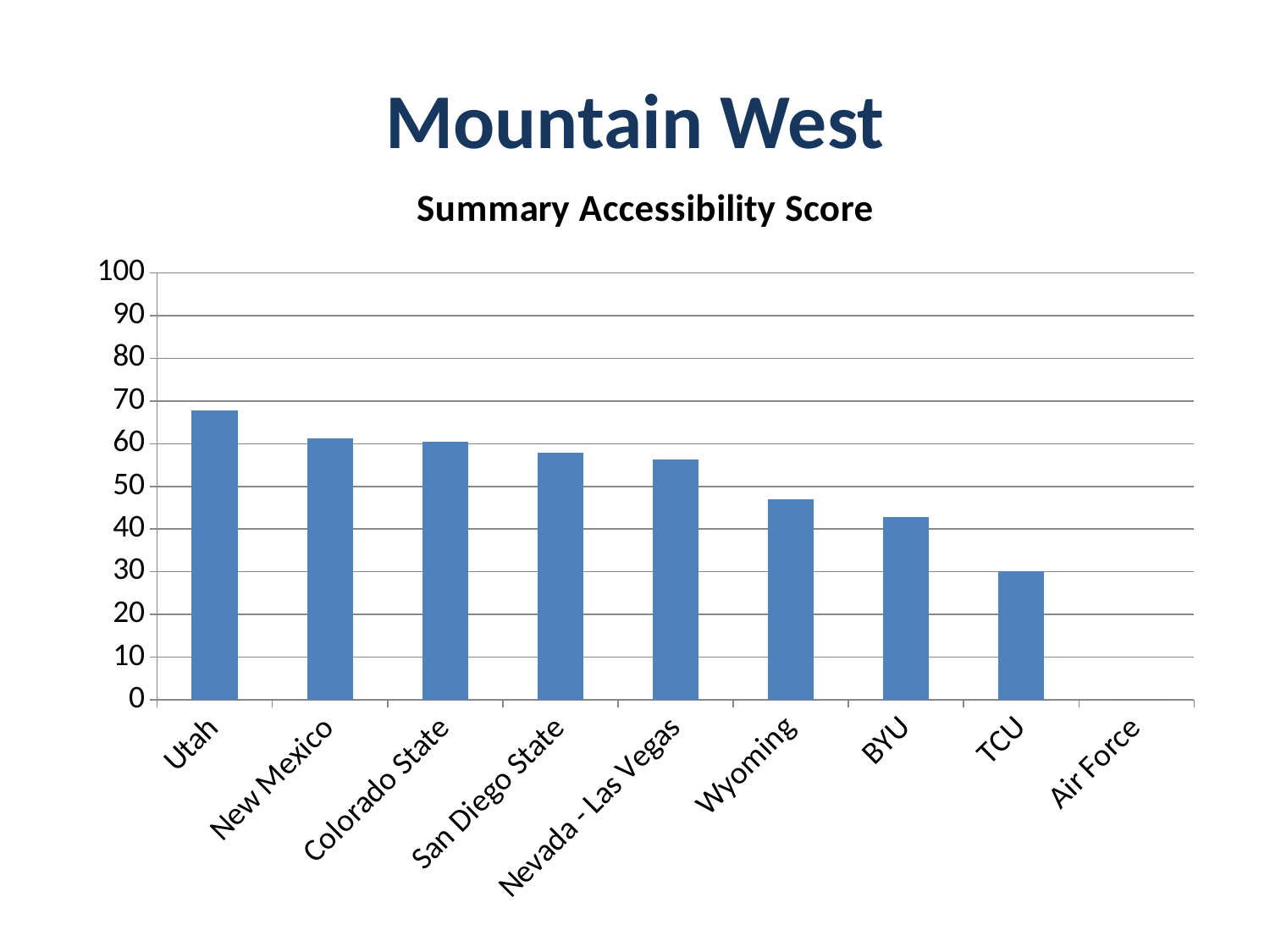
What is the title of the chart? Summary Accessibility Score Which has a higher Summary Accessibility Score, Wyoming or BYU? Wyoming Is the value for Wyoming greater or less than 50? less Is the value for Utah greater or less than 60? greater Which category has the highest Summary Accessibility Score? Utah Which category has the shortest visible bar in the chart? TCU Is the value for BYU greater or less than 40? greater Which category has no visible bar in the chart? Air Force Do the values generally rise or fall moving from left to right along the x axis? fall What kind of chart is shown on the slide? bar chart How many categories are shown on the x axis of the chart? 9